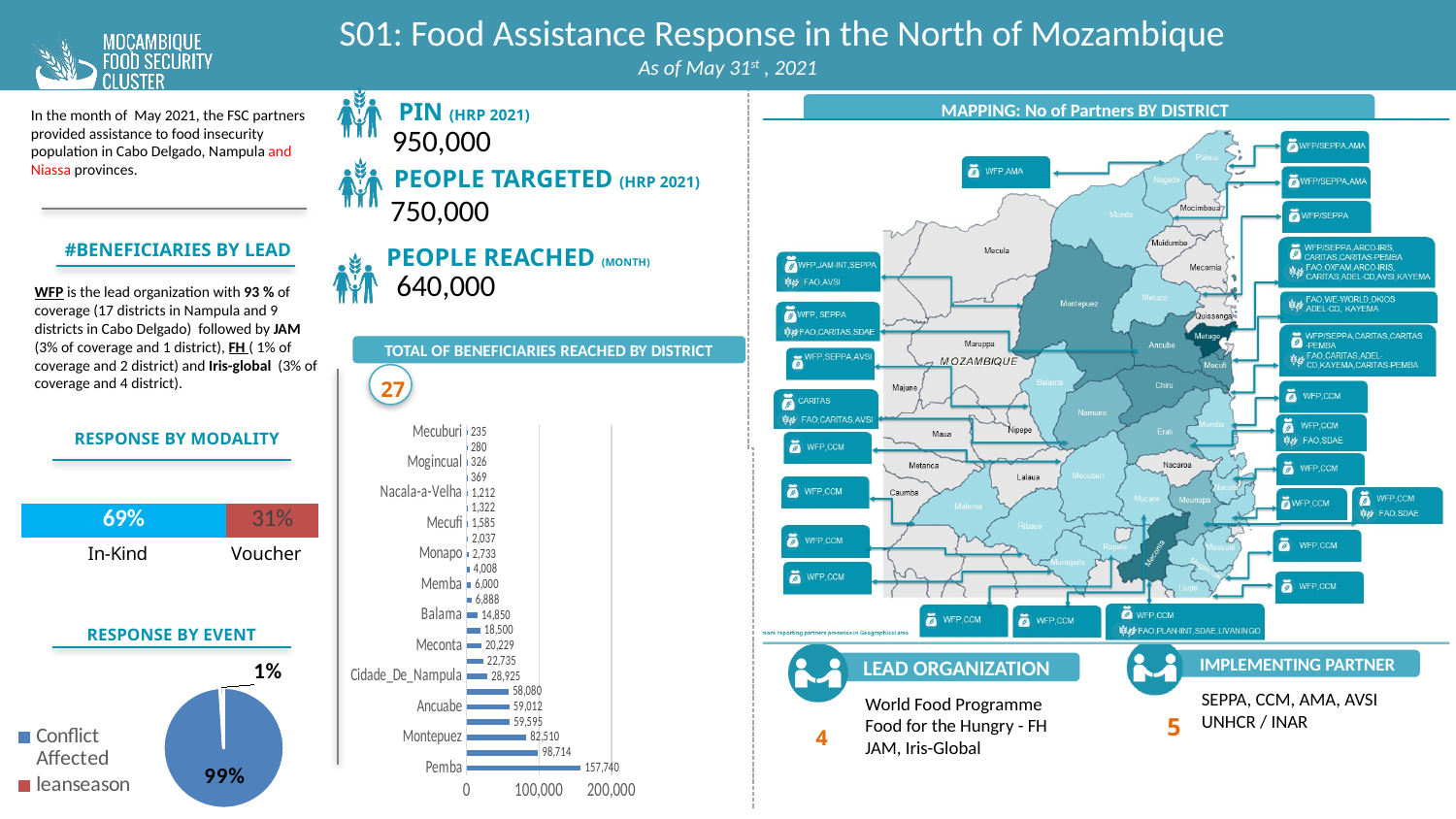
In the 'TOTAL OF BENEFICIARIES REACHED BY DISTRICT' chart, what is the value for Montepuez? 82,510 In the 'RESPONSE BY EVENT' pie chart, what share is Conflict Affected? 99% In the 'TOTAL OF BENEFICIARIES REACHED BY DISTRICT' chart, which labelled district has the lowest number of beneficiaries reached? Mecuburi In the 'TOTAL OF BENEFICIARIES REACHED BY DISTRICT' chart, is the value for Pemba greater or less than 100,000? greater In the 'RESPONSE BY EVENT' pie chart, what share is leanseason? 1% In the 'RESPONSE BY MODALITY' chart, what is the difference between the In-Kind and Voucher percentages? 38% In the 'TOTAL OF BENEFICIARIES REACHED BY DISTRICT' chart, what is the difference between the values for Pemba and Montepuez? 75,230 In the 'RESPONSE BY MODALITY' chart, what percentage is In-Kind? 69% What kind of chart is the 'TOTAL OF BENEFICIARIES REACHED BY DISTRICT' chart? bar chart In the 'TOTAL OF BENEFICIARIES REACHED BY DISTRICT' chart, which district has the highest number of beneficiaries reached? Pemba In the 'TOTAL OF BENEFICIARIES REACHED BY DISTRICT' chart, which is larger, the value for Ancuabe or the value for Meconta? Ancuabe In the 'TOTAL OF BENEFICIARIES REACHED BY DISTRICT' chart, how many beneficiaries were reached in Pemba? 157,740